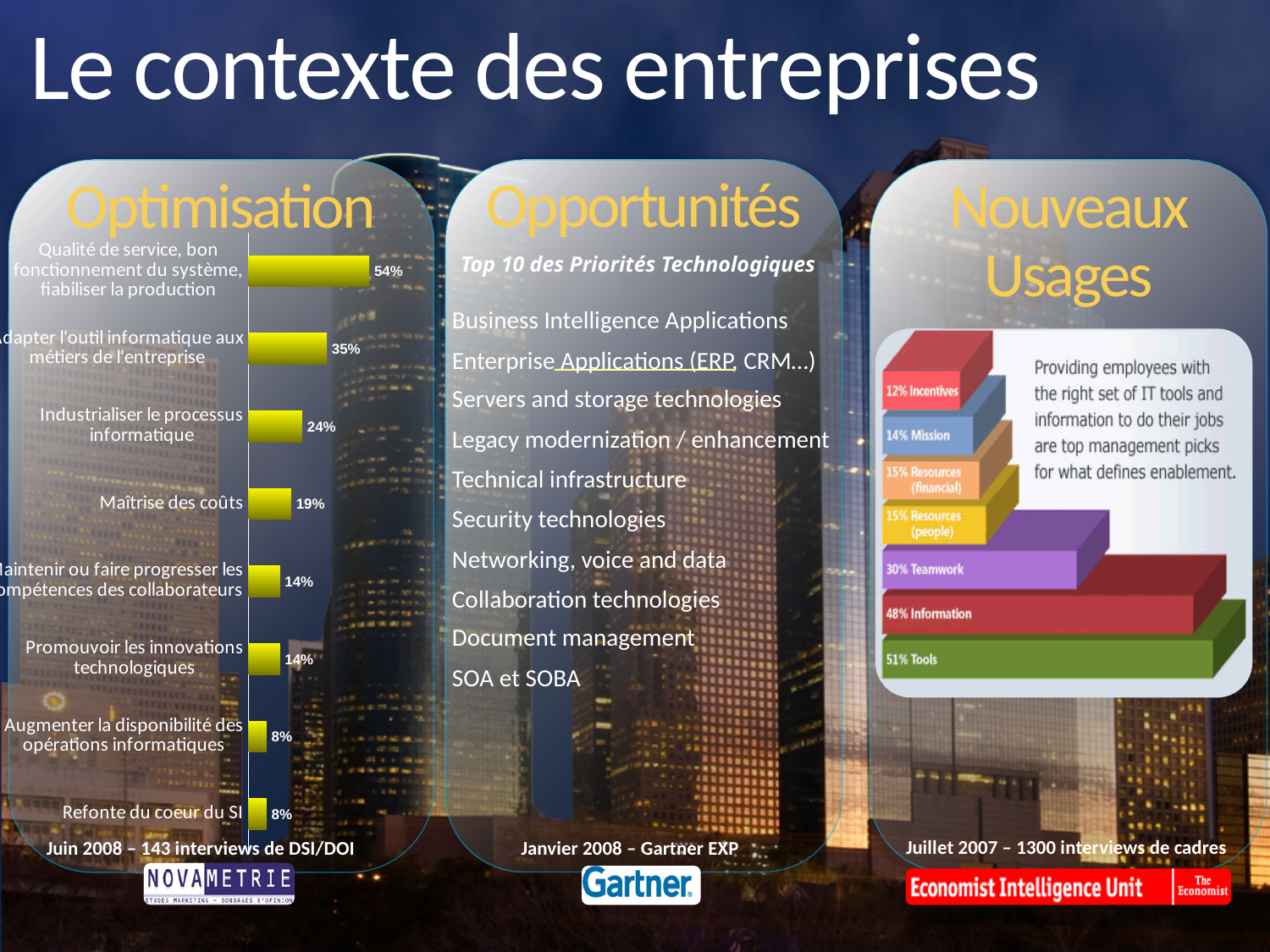
In the Optimisation bar chart, what is the value for "Promouvoir les innovations technologiques"? 14% In the Optimisation bar chart, which category has the highest value? Qualité de service, bon fonctionnement du système, fiabiliser la production In the Optimisation bar chart, what is the value for "Refonte du coeur du SI"? 8% In the Optimisation bar chart, what is the difference between the value for "Qualité de service, bon fonctionnement du système, fiabiliser la production" and the value for "Maîtrise des coûts"? 35% In the Optimisation bar chart, what is the highest value shown? 54% How many categories does the Optimisation bar chart show? 8 What kind of chart is shown in the Optimisation panel? Bar chart What colour are the bars in the Optimisation bar chart? Yellow In the Optimisation bar chart, which is larger: the value for "Industrialiser le processus informatique" or the value for "Maîtrise des coûts"? Industrialiser le processus informatique In the Optimisation bar chart, what is the difference between the value for "Industrialiser le processus informatique" and the value for "Refonte du coeur du SI"? 16% In the Optimisation bar chart, what is the value for "Industrialiser le processus informatique"? 24% In the Optimisation bar chart, what is the value for "Maîtrise des coûts"? 19%